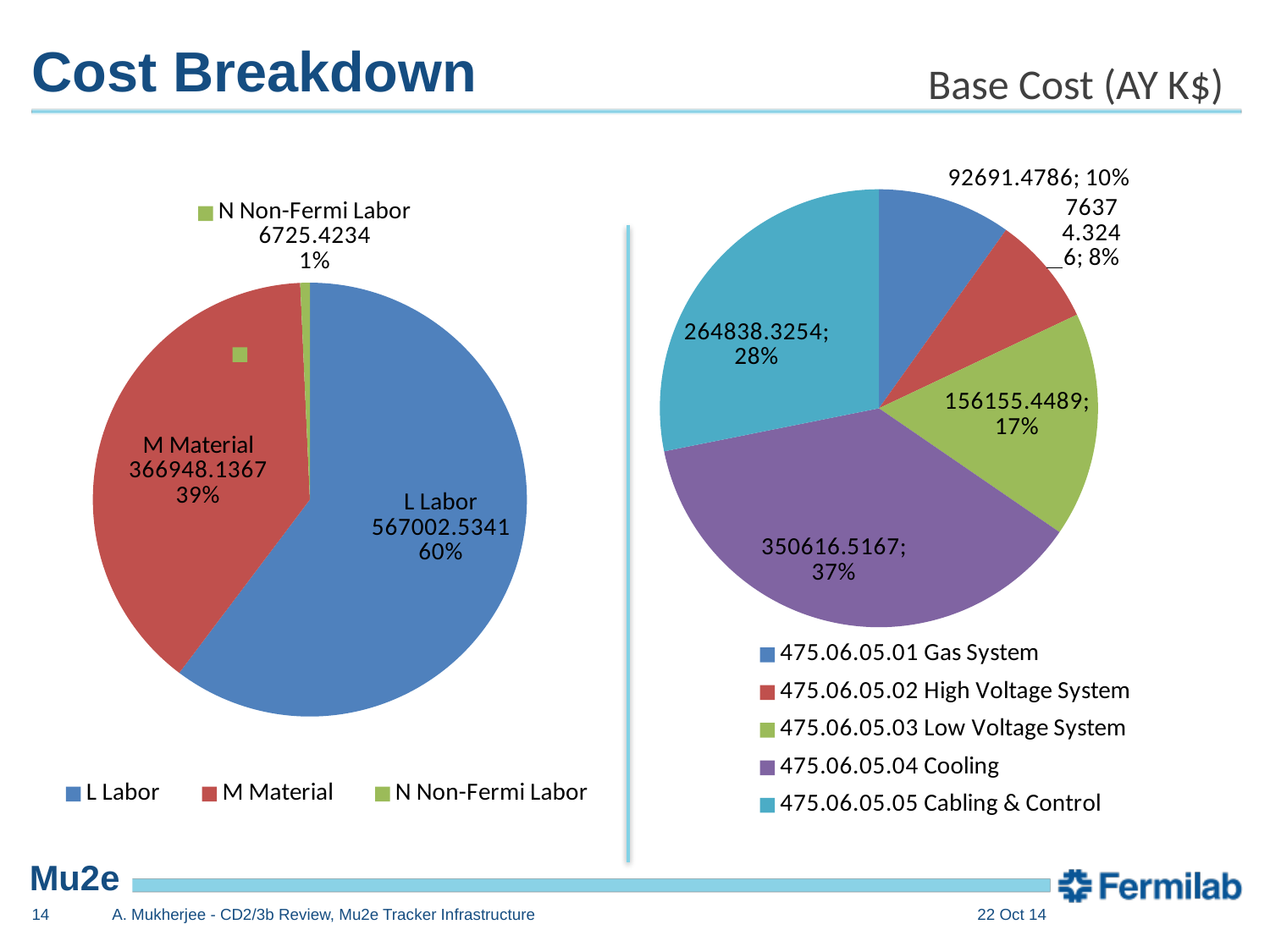
On the left pie chart, what is the difference between the L Labor and M Material values? 200054.3974 What type of chart is shown on the right side of the slide? Pie chart How many categories does the legend of the left pie chart list? 3 On the right pie chart, what is the value shown for 475.06.05.04 Cooling? 350616.5167 On the right pie chart, what share of the pie does 475.06.05.05 Cabling & Control represent? 28% On the left pie chart, which category has the largest slice? L Labor On the right pie chart, which is larger, the slice for 475.06.05.03 Low Voltage System or the slice for 475.06.05.01 Gas System? 475.06.05.03 Low Voltage System On the right pie chart, which category has the largest slice? 475.06.05.04 Cooling How many categories does the legend of the right pie chart list? 5 On the left pie chart, what share of the pie does M Material represent? 39% On the left pie chart, which category has the smallest slice? N Non-Fermi Labor On the left pie chart, what is the value shown for L Labor? 567002.5341